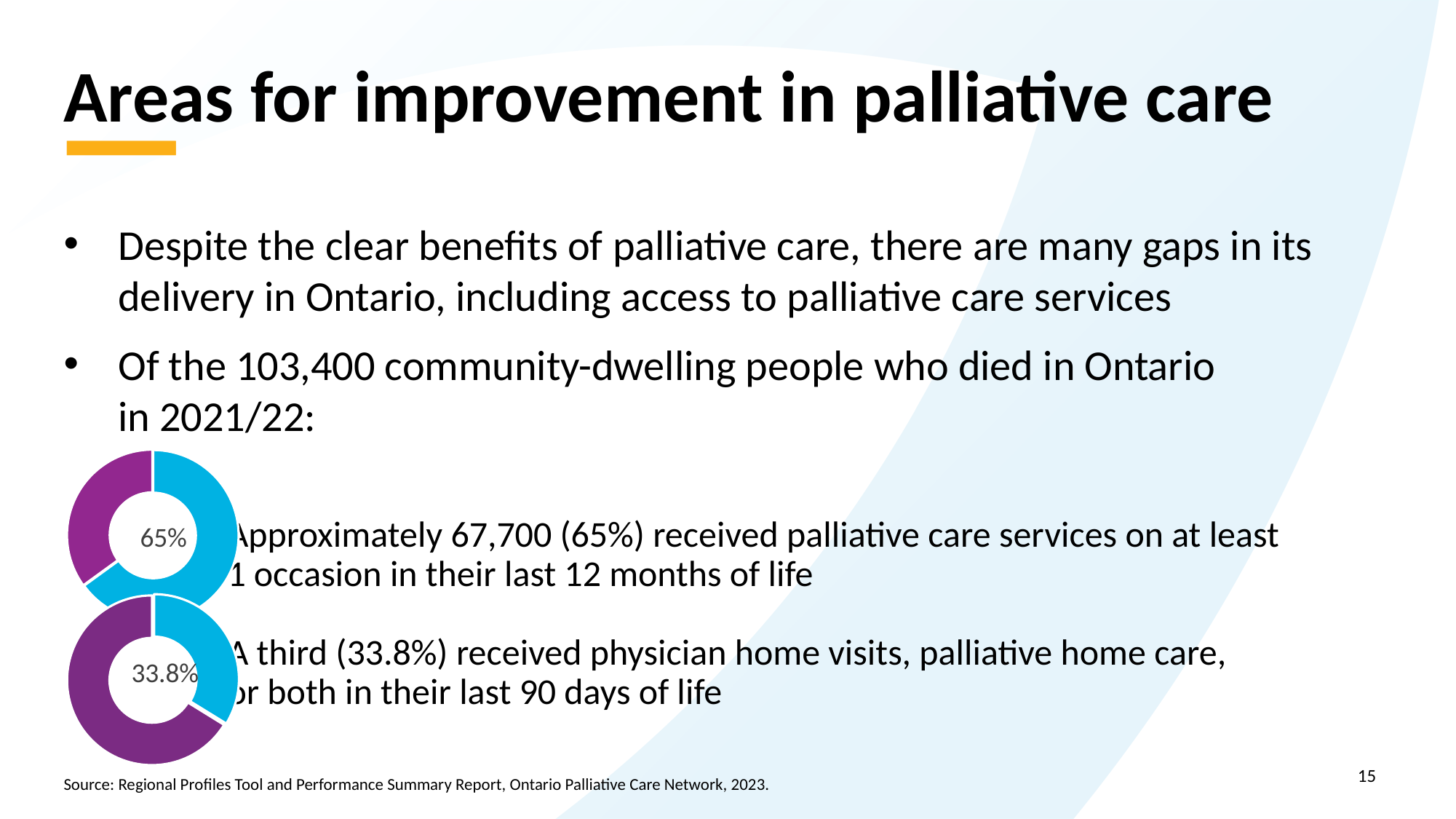
In the top donut chart, is the blue (highlighted) portion greater or less than 50% of the ring? greater What kind of chart is used on the slide to show the 65% and 33.8% figures? Donut (pie) chart In the bottom donut chart, which colour occupies the larger portion of the ring, blue or purple? Purple What percentage of community-dwelling people who died in Ontario in 2021/22 received physician home visits, palliative home care, or both in their last 90 days of life, according to the bottom donut chart? 33.8% In the bottom donut chart, is the blue (highlighted) portion greater or less than 50% of the ring? less What two colours are used in the donut charts on the slide? Blue and purple How many donut charts are shown on the slide? 2 Which donut chart shows the larger highlighted percentage, the top one or the bottom one? The top one What value is printed in the centre of the top donut chart? 65% What is the difference between the percentage shown in the top donut chart and the percentage shown in the bottom donut chart? 31.2 percentage points What value is printed in the centre of the bottom donut chart? 33.8% In the top donut chart, which colour occupies the larger portion of the ring, blue or purple? Blue